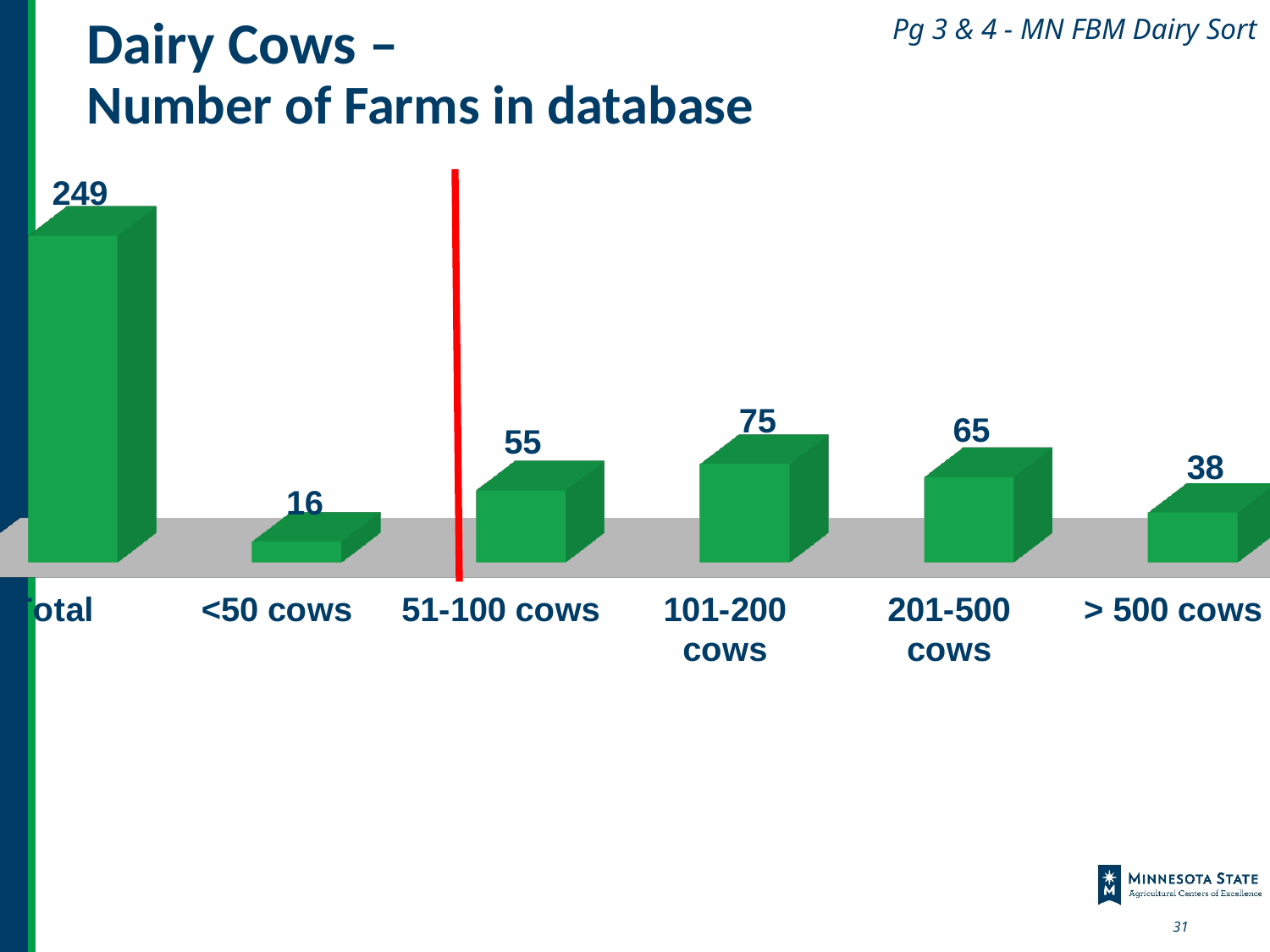
Excluding the Total bar, which herd-size category has the most farms? 101-200 cows What is the value for the > 500 cows category? 38 What type of chart is shown on the slide? Bar chart Which has more farms, 51-100 cows or > 500 cows? 51-100 cows How many farms are in the <50 cows category? 16 What value is shown for the 101-200 cows category? 75 Which herd-size category has the fewest farms? <50 cows What is the difference between the number of farms with 101-200 cows and those with 201-500 cows? 10 How many farms have 201-500 cows? 65 How many categories are shown on the x axis of the chart? 6 What is the number of farms for 51-100 cows? 55 What is the value shown on the first bar (Total)? 249